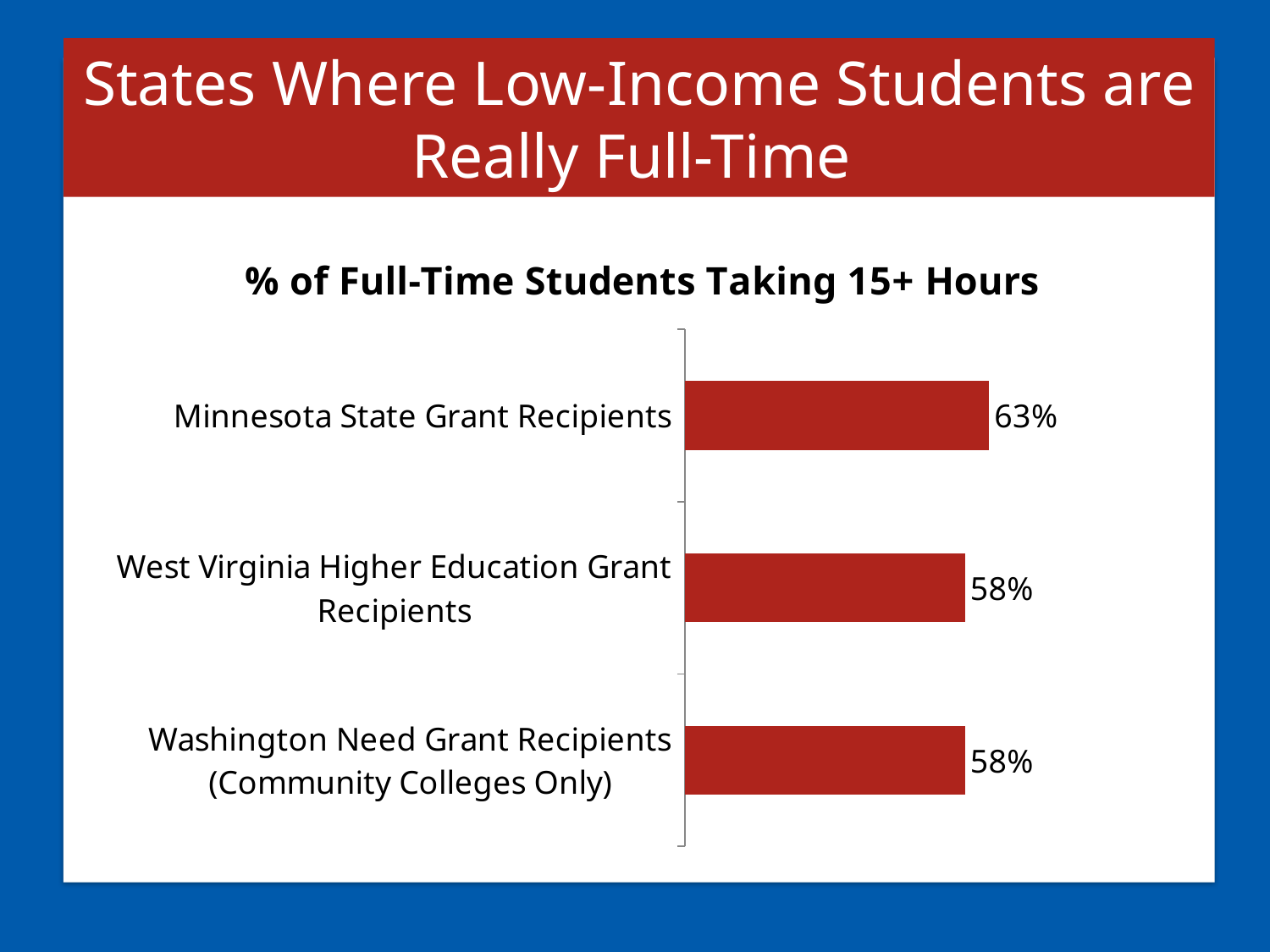
What is the difference between the values for Minnesota State Grant Recipients and West Virginia Higher Education Grant Recipients? 5% Which is larger, the value for Minnesota State Grant Recipients or the value for Washington Need Grant Recipients (Community Colleges Only)? Minnesota State Grant Recipients Which category has the highest value? Minnesota State Grant Recipients How many categories are shown in the chart? 3 What is the value for West Virginia Higher Education Grant Recipients? 58% What is the title of the chart? % of Full-Time Students Taking 15+ Hours What kind of chart is shown on the slide? Bar chart What colour are the bars in the chart? Red What is the value for Washington Need Grant Recipients (Community Colleges Only)? 58% What is the value for Minnesota State Grant Recipients? 63% Do West Virginia Higher Education Grant Recipients and Washington Need Grant Recipients (Community Colleges Only) have the same value? Yes